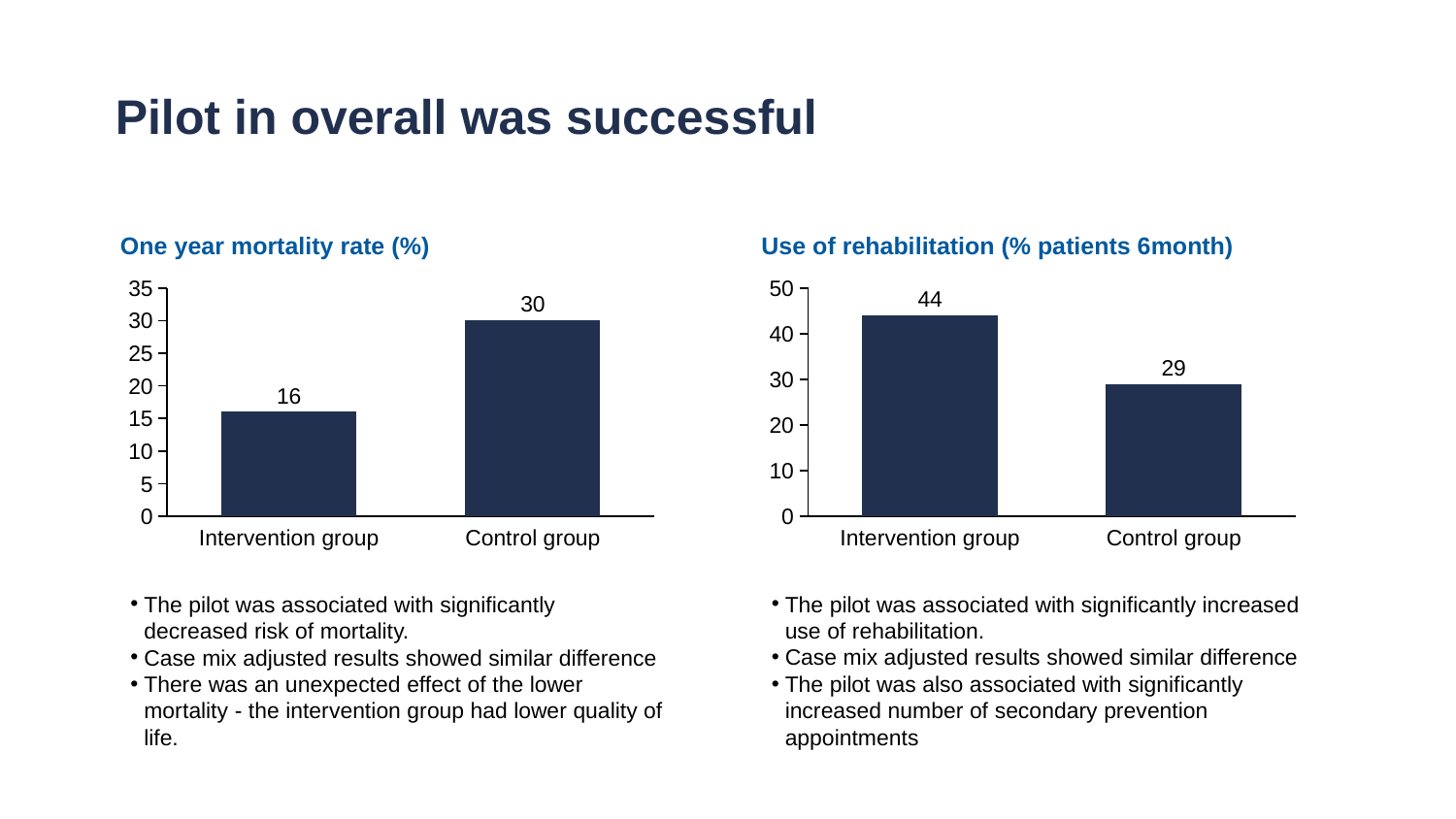
In the 'Use of rehabilitation (% patients 6month)' chart, is the value for the Intervention group greater or less than 40? greater In the 'Use of rehabilitation (% patients 6month)' chart, which group has the lower value? Control group In the 'Use of rehabilitation (% patients 6month)' chart, what is the value for the Intervention group? 44 What is the title of the chart on the left side of the slide? One year mortality rate (%) In the 'Use of rehabilitation (% patients 6month)' chart, what is the value for the Control group? 29 In the 'One year mortality rate (%)' chart, what is the value for the Intervention group? 16 What kind of chart is the 'Use of rehabilitation (% patients 6month)' chart? Bar chart In the 'One year mortality rate (%)' chart, what is the value for the Control group? 30 In the 'One year mortality rate (%)' chart, what is the difference between the Control group and the Intervention group? 14 In the 'One year mortality rate (%)' chart, which group has the higher value? Control group In the 'Use of rehabilitation (% patients 6month)' chart, what is the difference between the Intervention group and the Control group? 15 How many categories are shown in the 'One year mortality rate (%)' chart? 2